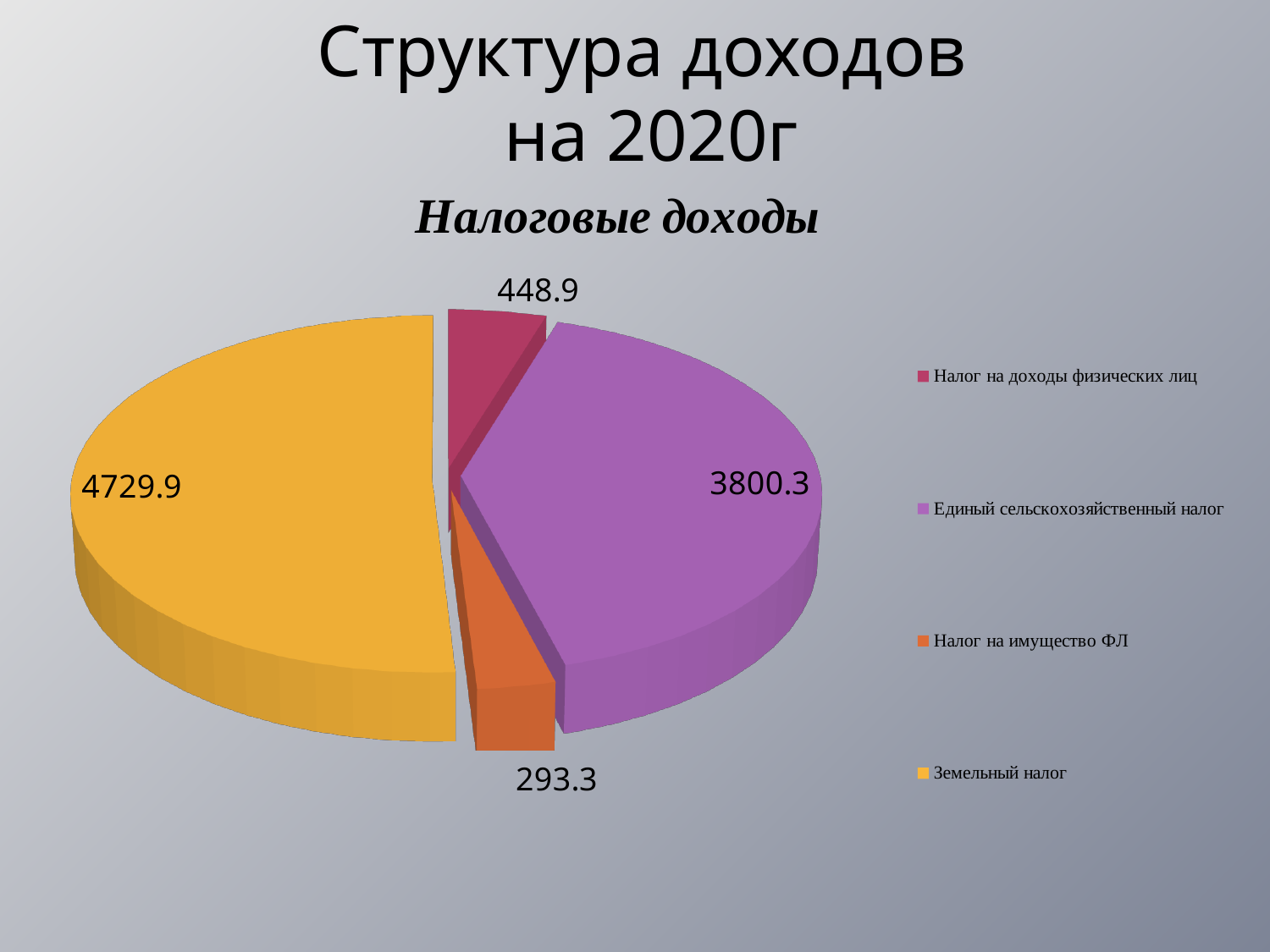
What is the value for Единый сельскохозяйственный налог? 3800.3 What is the value for Земельный налог? 4729.9 What is the difference between the values for Земельный налог and Единый сельскохозяйственный налог? 929.6 What is the subtitle shown above the pie chart? Налоговые доходы What type of chart is shown on the slide? pie chart How many categories does the pie chart show? 4 Which category has the smallest slice of the pie? Налог на имущество ФЛ Which category has the largest slice of the pie? Земельный налог What is the difference between the values for Налог на доходы физических лиц and Налог на имущество ФЛ? 155.6 What is the value for Налог на имущество ФЛ? 293.3 Which is larger: Единый сельскохозяйственный налог or Налог на доходы физических лиц? Единый сельскохозяйственный налог What is the value for Налог на доходы физических лиц? 448.9